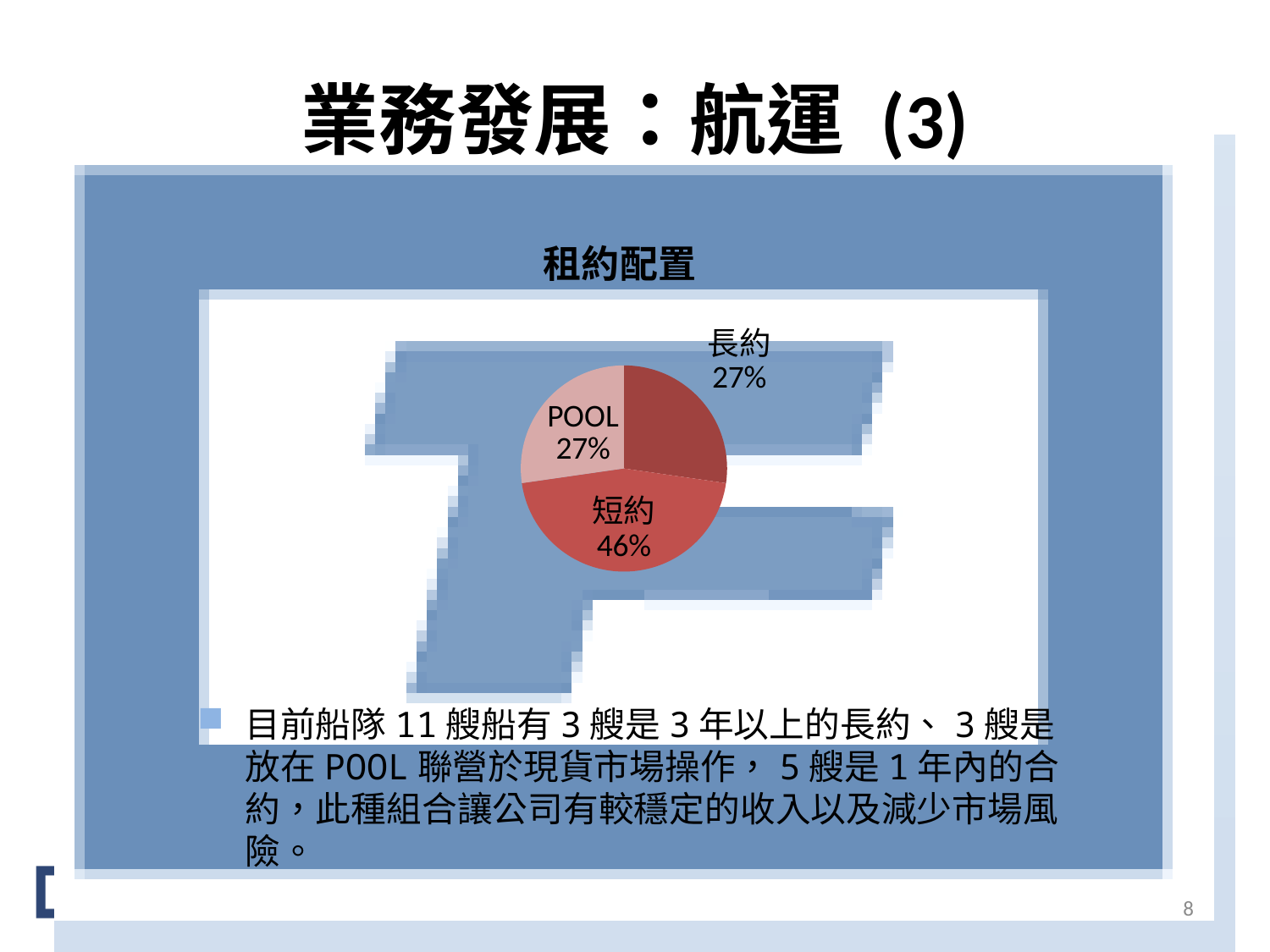
Do 長約 and POOL have the same share of the pie? Yes Which category has the largest slice of the pie? 短約 What share of the pie does 短約 represent? 46% Which is larger, 短約 or 長約? 短約 What kind of chart is shown on the slide? pie chart What is the value shown for 長約? 27% What is the value shown for POOL? 27% What is the difference between the shares of 短約 and POOL? 19% What is the combined share of 長約 and POOL? 54% How many slices does the pie chart have? 3 What is the title of the chart? 租約配置